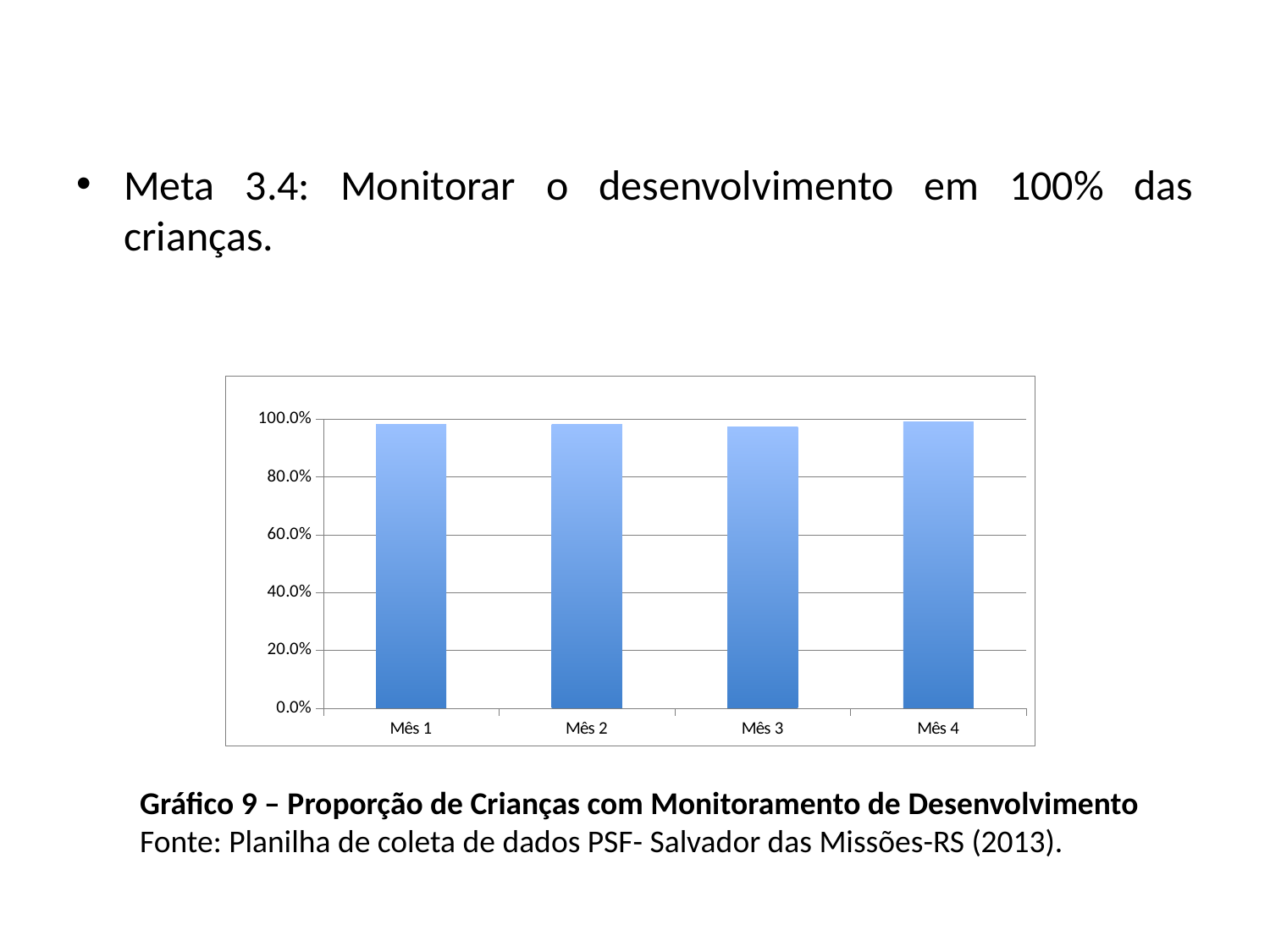
What is the label of the first category on the x axis? Mês 1 Is the value for Mês 4 greater or less than 80.0%? greater What kind of chart is shown on the slide? bar chart What is the highest tick value shown on the y axis? 100.0% Is the value for Mês 3 greater or less than 60.0%? greater What is the title given for the chart in the caption below it? Gráfico 9 – Proporção de Crianças com Monitoramento de Desenvolvimento Is the value for Mês 2 greater or less than 80.0%? greater How many categories (months) are shown on the x axis of the chart? 4